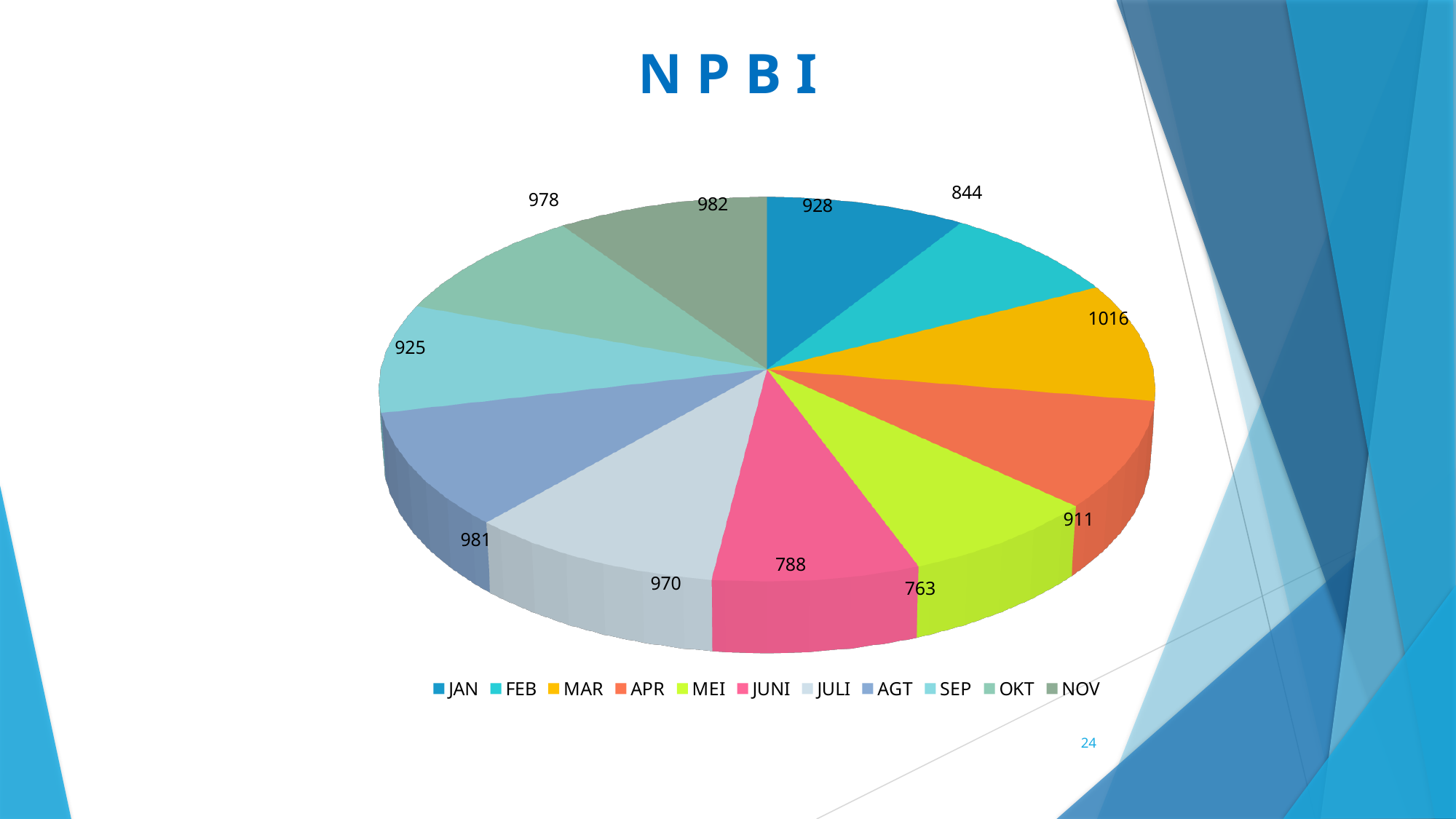
Which month has the highest value in the NPBI pie chart? MAR Which month has the lowest value in the NPBI pie chart? MEI What is the title of the chart on the slide? NPBI What is the value for SEP in the NPBI pie chart? 925 Which has the larger value in the NPBI pie chart, APR or FEB? APR What is the difference between the values for JAN and FEB in the NPBI pie chart? 84 What is the value for JUNI in the NPBI pie chart? 788 What kind of chart is shown on the slide? Pie chart Which has the larger value in the NPBI pie chart, JULI or AGT? AGT What is the difference between the values for MAR and MEI in the NPBI pie chart? 253 What is the value for MAR in the NPBI pie chart? 1016 How many slices does the NPBI pie chart have? 11